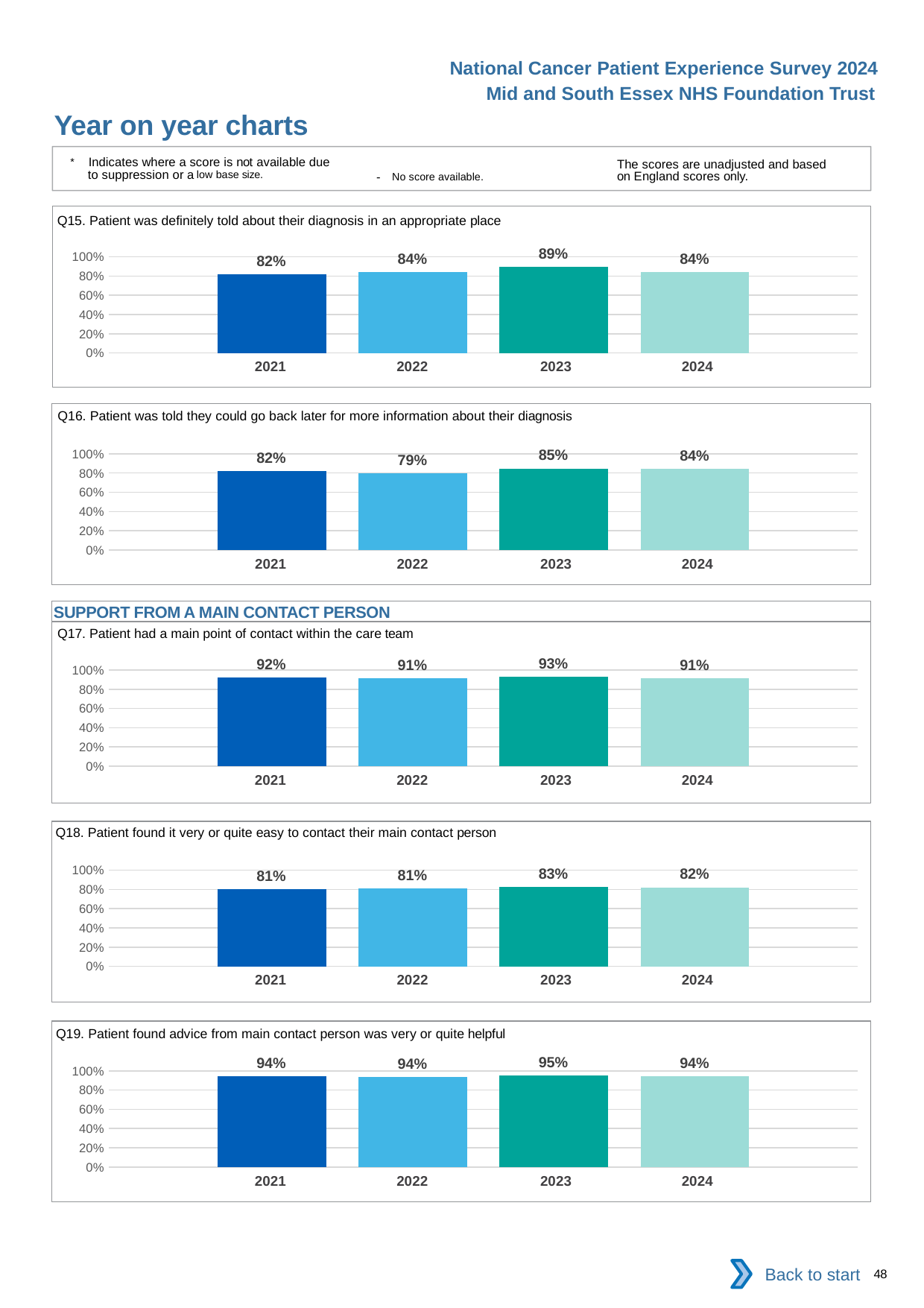
In the Q19 chart (Patient found advice from main contact person was very or quite helpful), which year has the highest value? 2023 In the Q17 chart, which is larger, the value for 2021 or the value for 2022? 2021 How many years (categories) are shown in the Q19 chart? 4 In the Q15 chart (Patient was definitely told about their diagnosis in an appropriate place), what is the value for 2023? 89% In the Q16 chart, is the value for 2021 greater or less than 60%? greater In the Q18 chart (Patient found it very or quite easy to contact their main contact person), what is the value for 2021? 81% In the Q18 chart, what is the difference between the 2023 value and the 2024 value? 1 percentage point What kind of chart is the Q15 chart? Bar chart In the Q17 chart (Patient had a main point of contact within the care team), what is the value for 2024? 91% In the Q16 chart, what is the difference between the 2023 value and the 2022 value? 6 percentage points In the Q15 chart, which year has the highest value? 2023 In the Q16 chart (Patient was told they could go back later for more information about their diagnosis), which year has the lowest value? 2022